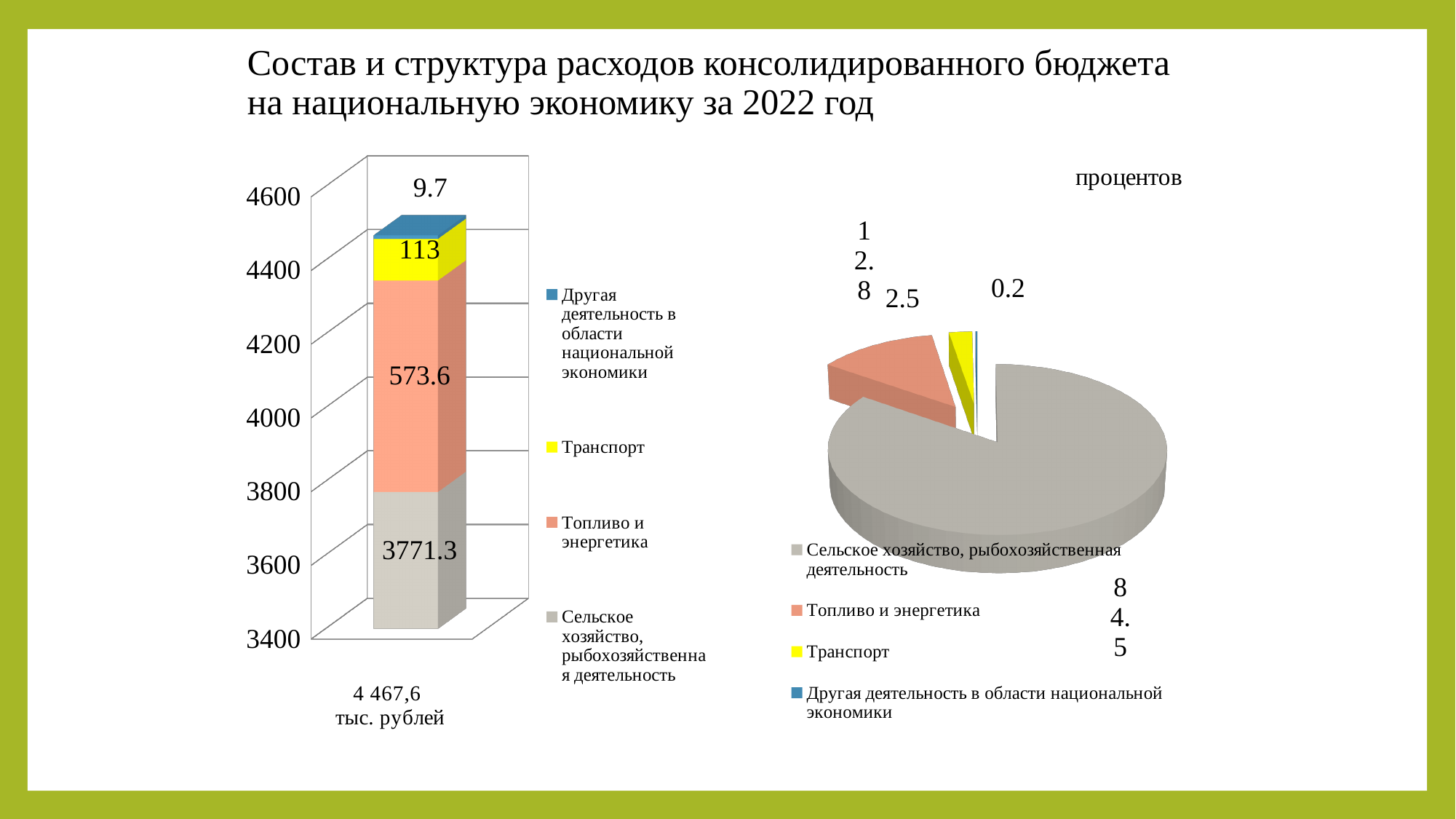
In the right pie chart, what share does Транспорт have? 2.5 What type of chart is shown on the left side of the slide? stacked bar chart In the left bar chart, what is the value for Сельское хозяйство, рыбохозяйственная деятельность? 3771.3 In the left bar chart, what is the value for Топливо и энергетика? 573.6 In the left bar chart, which segment has the largest value? Сельское хозяйство, рыбохозяйственная деятельность What type of chart is shown on the right side of the slide? pie chart In the left bar chart, what is the value for Другая деятельность в области национальной экономики? 9.7 How many series does the legend of the left bar chart list? 4 In the left bar chart, what is the value for Транспорт? 113 In the right pie chart, which slice is larger: Топливо и энергетика or Транспорт? Топливо и энергетика In the left bar chart, what is the difference between the values for Топливо и энергетика and Транспорт? 460.6 In the left bar chart, which segment has the smallest value? Другая деятельность в области национальной экономики